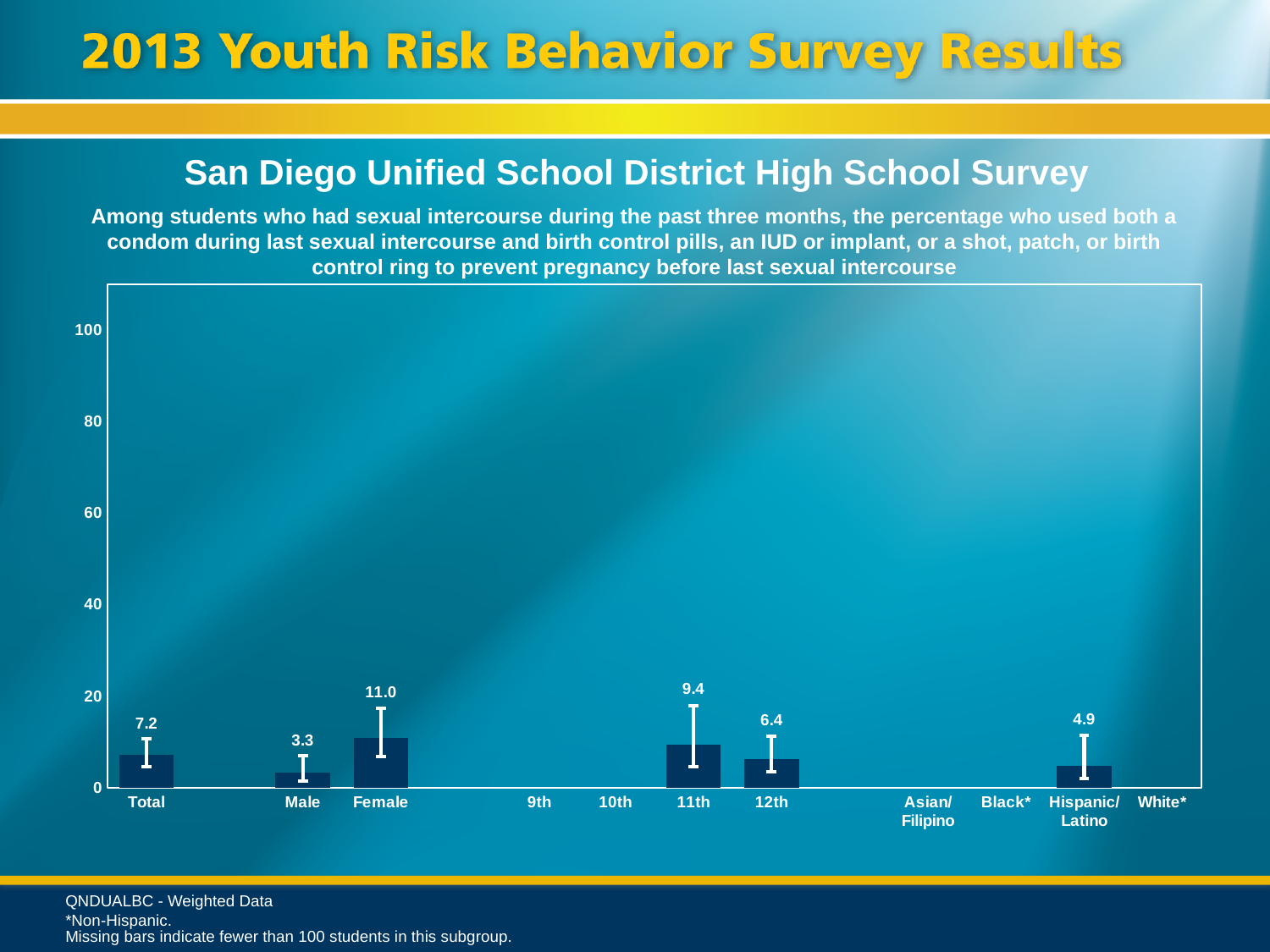
What is the value for Total? 7.2 Is the value for Female greater or less than 20? less Which category has the lowest value among the bars shown? Male What is the value for Female? 11.0 Which is larger, the value for 11th grade or 12th grade? 11th Which category has the highest value? Female What kind of chart is this? bar chart What is the difference between the Female and Male values? 7.7 What is the value for Hispanic/Latino? 4.9 What is the value for 11th grade? 9.4 What is the highest value shown on the y axis? 100 How many categories have bars plotted? 6